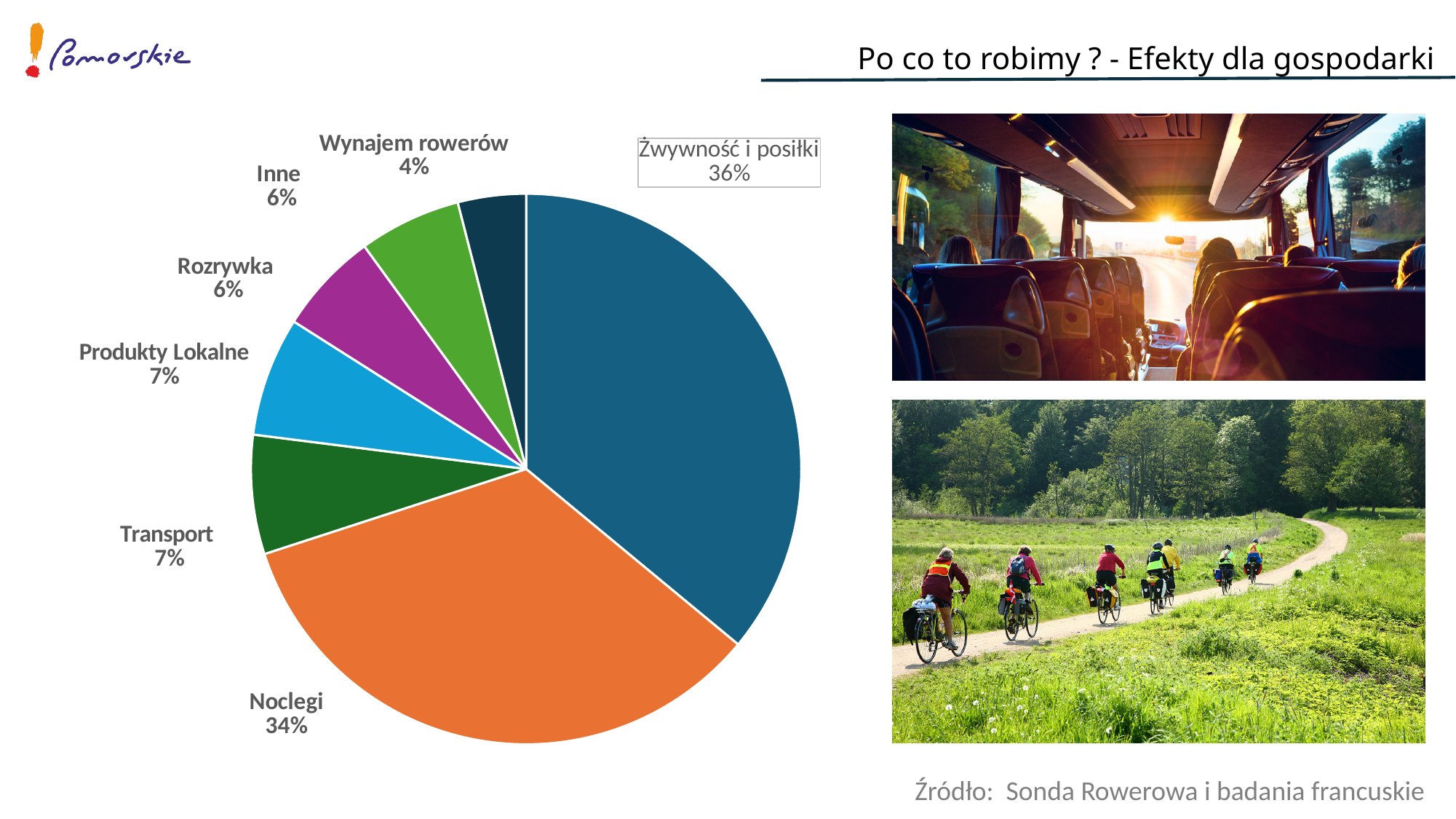
How many categories are shown in the pie chart? 7 Which is larger, the share for Rozrywka or the share for Noclegi? Noclegi What is the value for Produkty Lokalne in the pie chart? 7% What share of the pie chart does Noclegi represent? 34% What percentage is shown for Wynajem rowerów? 4% What colour is the Noclegi slice of the pie chart? Orange What is the difference in percentage points between Transport and Wynajem rowerów? 3 What is the difference in percentage points between Żwywność i posiłki and Noclegi? 2 What is the combined share of Żwywność i posiłki and Noclegi? 70% Which category has the smallest slice of the pie chart? Wynajem rowerów Which category has the largest slice of the pie chart? Żwywność i posiłki What type of chart is shown on the slide? Pie chart